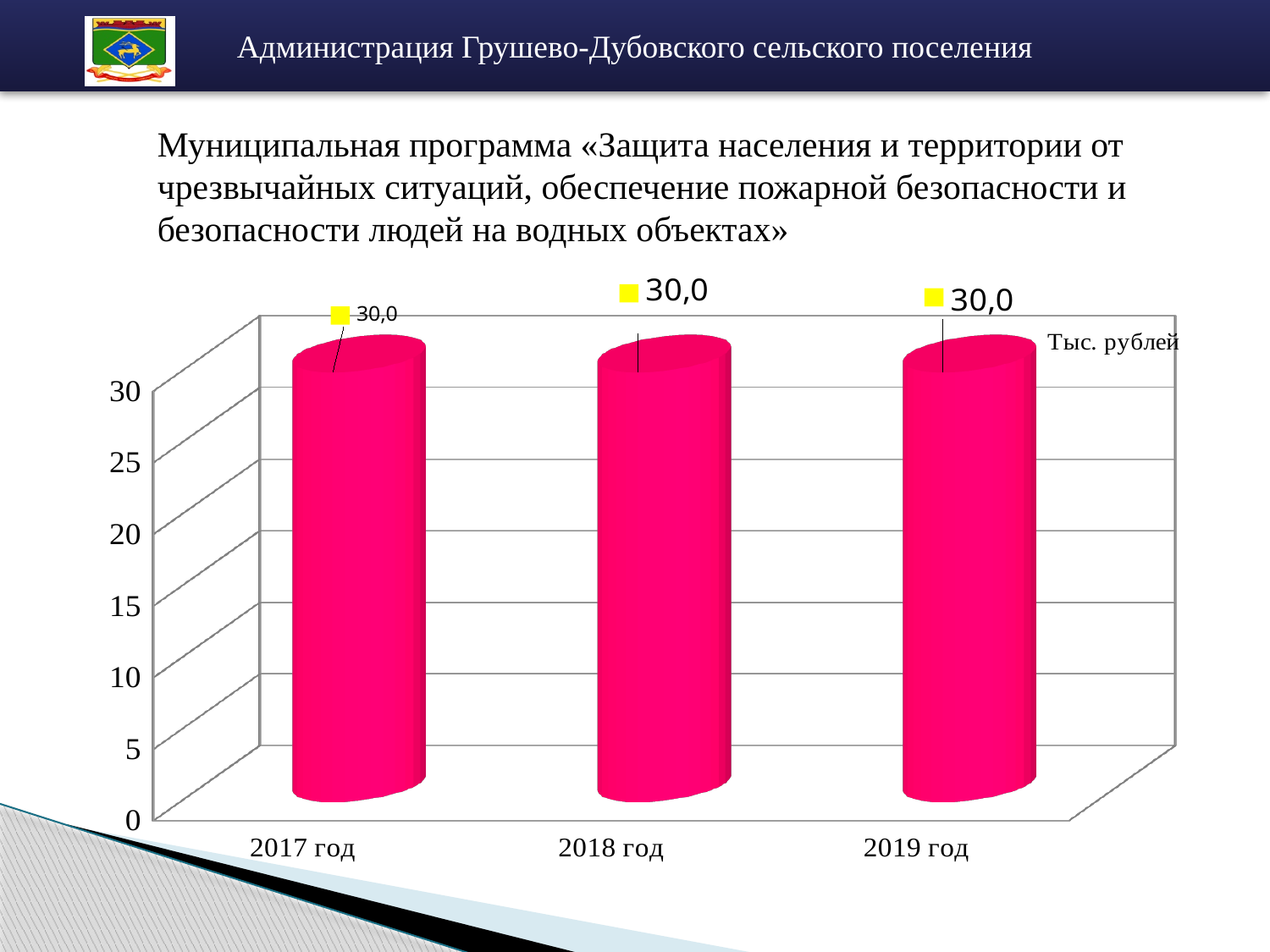
What is the highest value shown on the vertical axis of the chart? 30 What is the value for 2018 год? 30,0 What kind of chart is shown on the slide? bar chart What is the value for 2017 год? 30,0 Is the value for 2018 год greater or less than 25? greater How many categories (years) are shown on the x axis of the chart? 3 Is the value for 2019 год larger than, smaller than, or equal to the value for 2017 год? equal What is the value for 2019 год? 30,0 What is the difference between the values for 2018 год and 2017 год? 0,0 Do the values rise, fall, or stay the same from 2017 год to 2019 год? stay the same What unit of measurement is indicated on the chart? Тыс. рублей